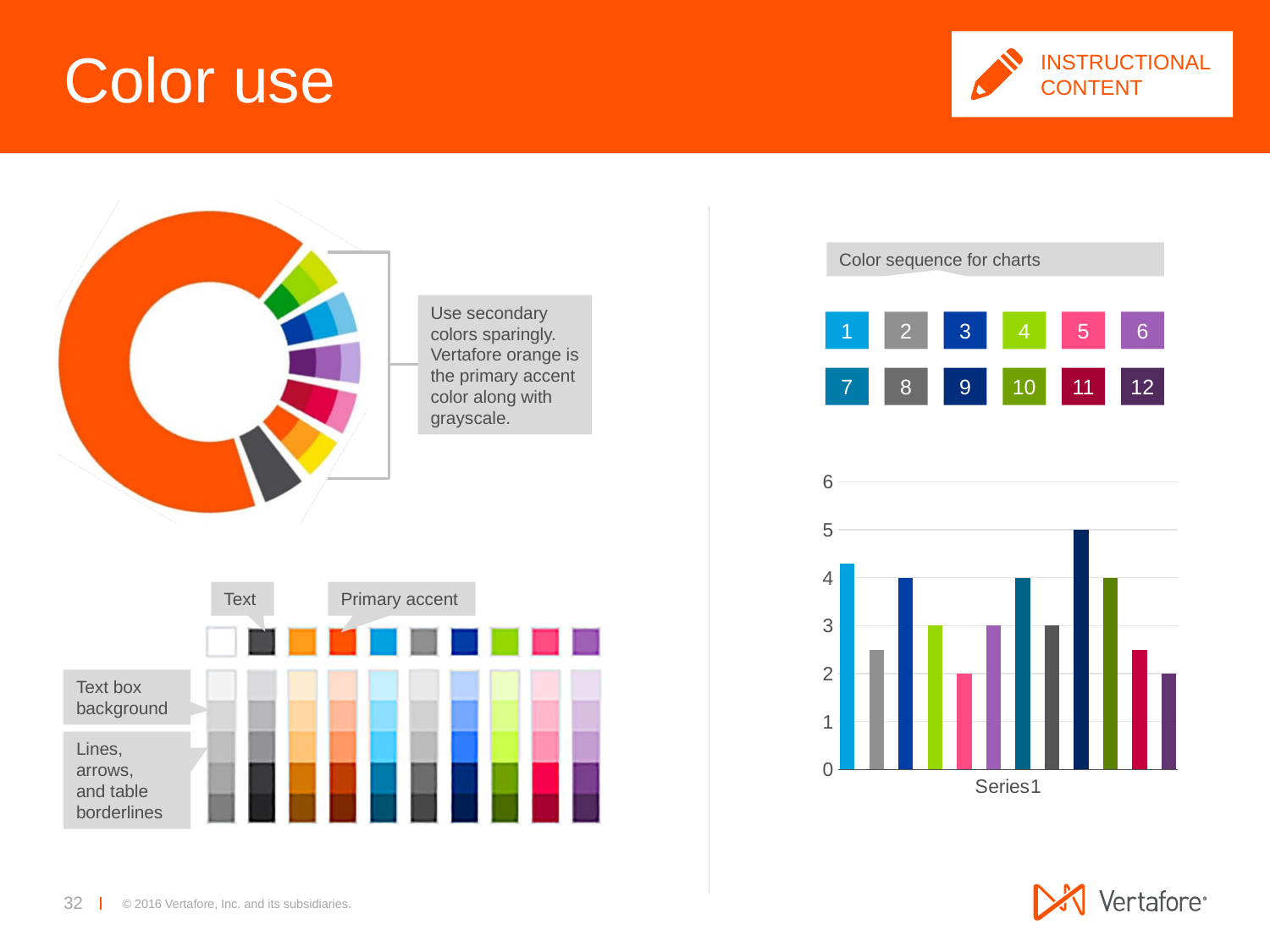
How many bars does the bar chart on the right side of the slide contain? 12 In the bar chart on the right, what value does the fifth bar from the left (pink) reach? 2 In the bar chart on the right, is the value of the second (gray) bar greater or less than 3? less In the bar chart on the right, is the value of the first (light blue) bar greater or less than 4? greater In the bar chart on the right, what value does the tallest (ninth, dark navy) bar reach? 5 In the bar chart on the right, which is taller: the ninth bar or the tenth bar? the ninth bar What label appears beneath the x axis of the bar chart on the right? Series1 What kind of chart is shown on the right side of the slide, below the 'Color sequence for charts' swatches? bar chart What is the highest value shown on the y axis of the bar chart on the right? 6 In the bar chart on the right, what value does the third bar from the left reach? 4 In the bar chart on the right, what is the difference between the ninth bar (5) and the twelfth bar (2)? 3 In the bar chart on the right, which bar (counting from the left) is the tallest? the ninth bar